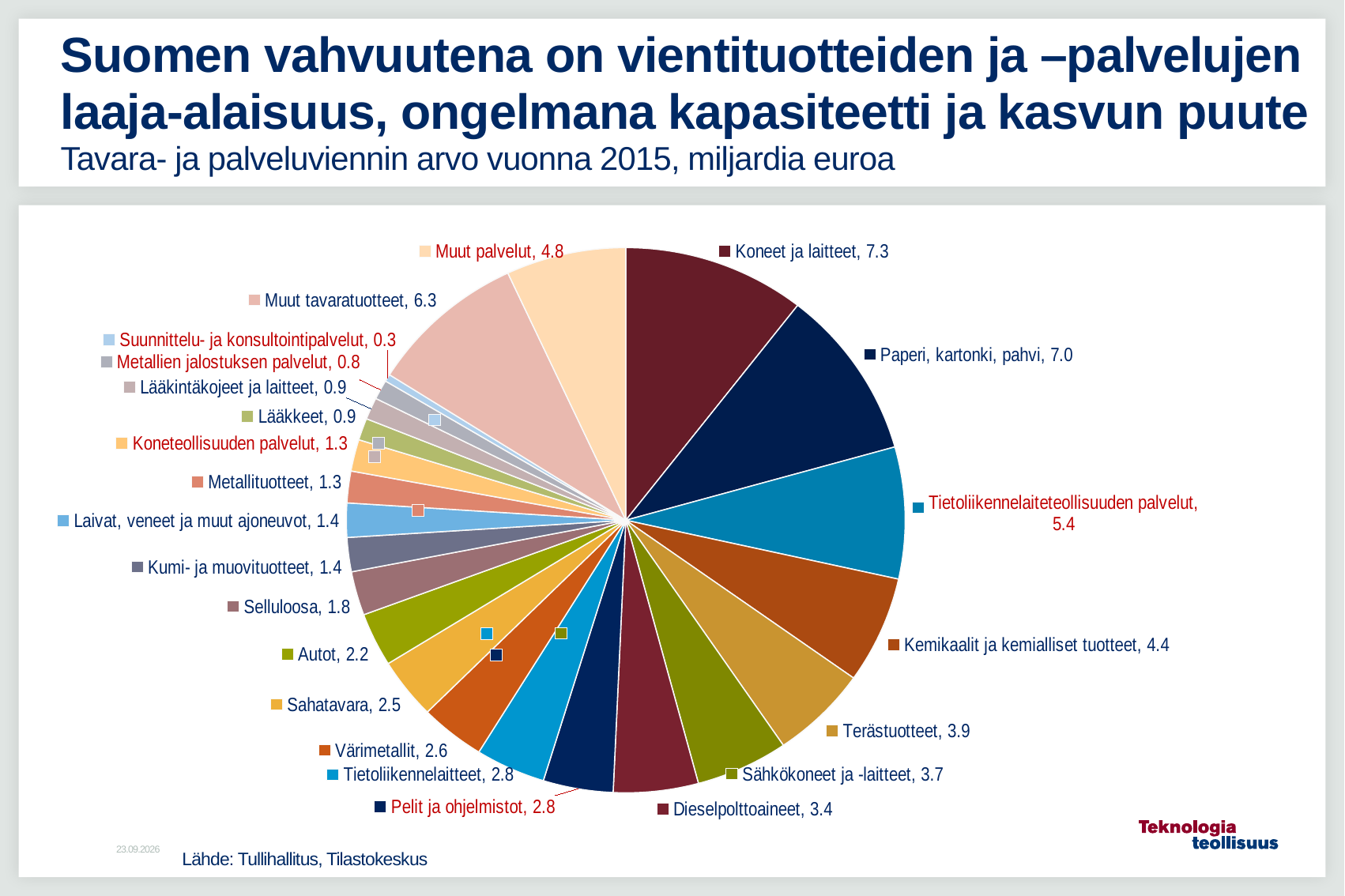
What is the value for Sahatavara? 2.5 What is the value for Tietoliikennelaiteteollisuuden palvelut? 5.4 What kind of chart is shown on the slide? pie chart Which category has the highest value in the pie chart? Koneet ja laitteet What is the value for Muut tavaratuotteet? 6.3 Which is larger, the value for Dieselpolttoaineet or the value for Sähkökoneet ja -laitteet? Sähkökoneet ja -laitteet What is the difference between the values for Kemikaalit ja kemialliset tuotteet and Terästuotteet? 0.5 What is the value for Koneet ja laitteet? 7.3 According to the subtitle, what year and unit does the chart describe? 2015, miljardia euroa What is the difference between the values for Koneet ja laitteet and Paperi, kartonki, pahvi? 0.3 How many categories (slices) does the pie chart have? 23 Which category has the lowest value in the pie chart? Suunnittelu- ja konsultointipalvelut